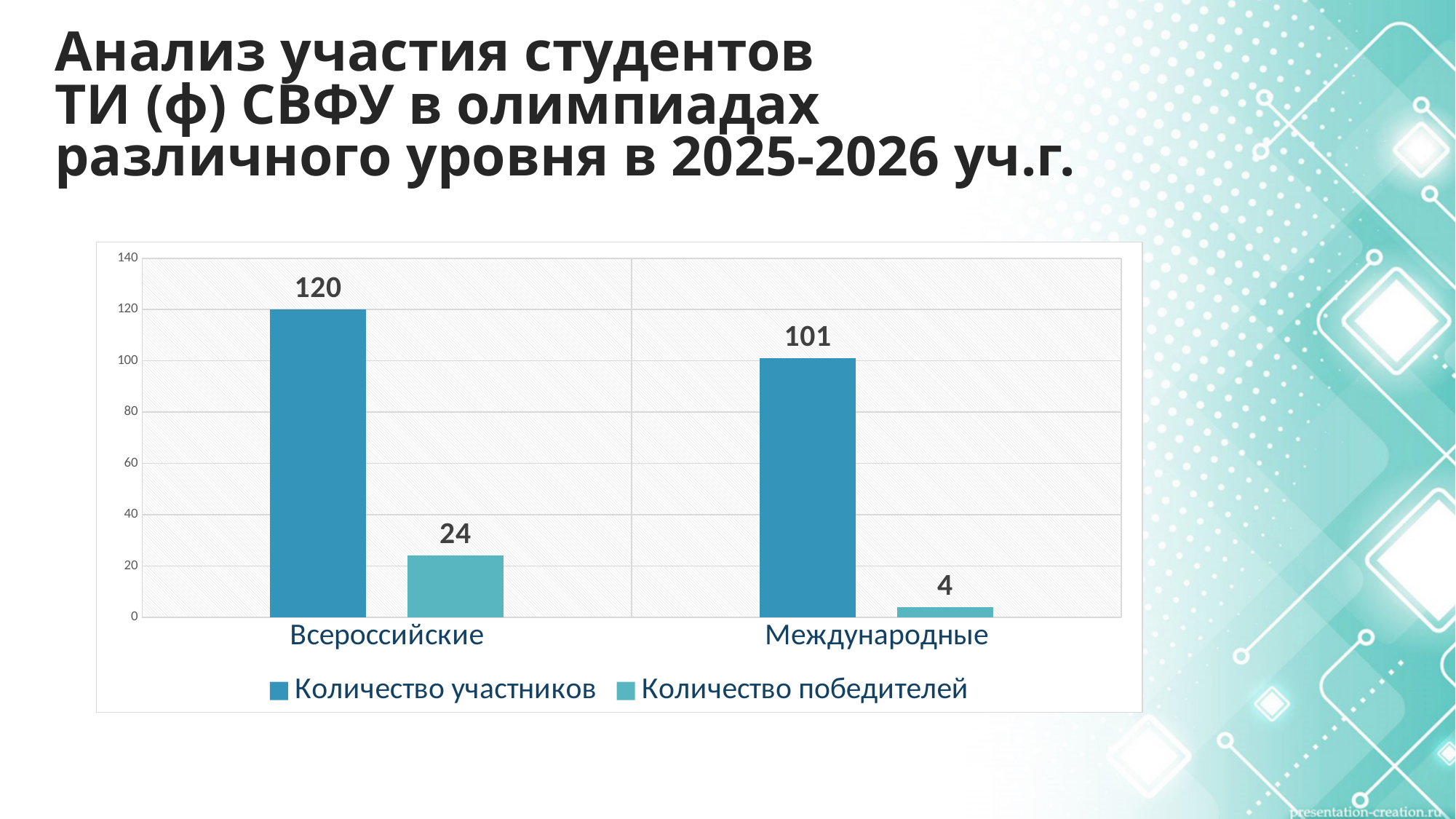
Which category has the highest number of participants (Количество участников)? Всероссийские Which is larger: the number of winners for Всероссийские or for Международные olympiads? Всероссийские What is the difference between the number of participants for Всероссийские and Международные olympiads? 19 How many categories are shown on the x axis of the chart? 2 What kind of chart is shown on the slide? Bar chart How many series does the chart legend list? 2 What is the difference between the number of winners for Всероссийские and Международные olympiads? 20 What is the number of winners (Количество победителей) for Международные olympiads? 4 What is the number of participants (Количество участников) for Всероссийские olympiads? 120 What is the number of participants (Количество участников) for Международные olympiads? 101 Which category has the lowest number of winners (Количество победителей)? Международные What is the number of winners (Количество победителей) for Всероссийские olympiads? 24